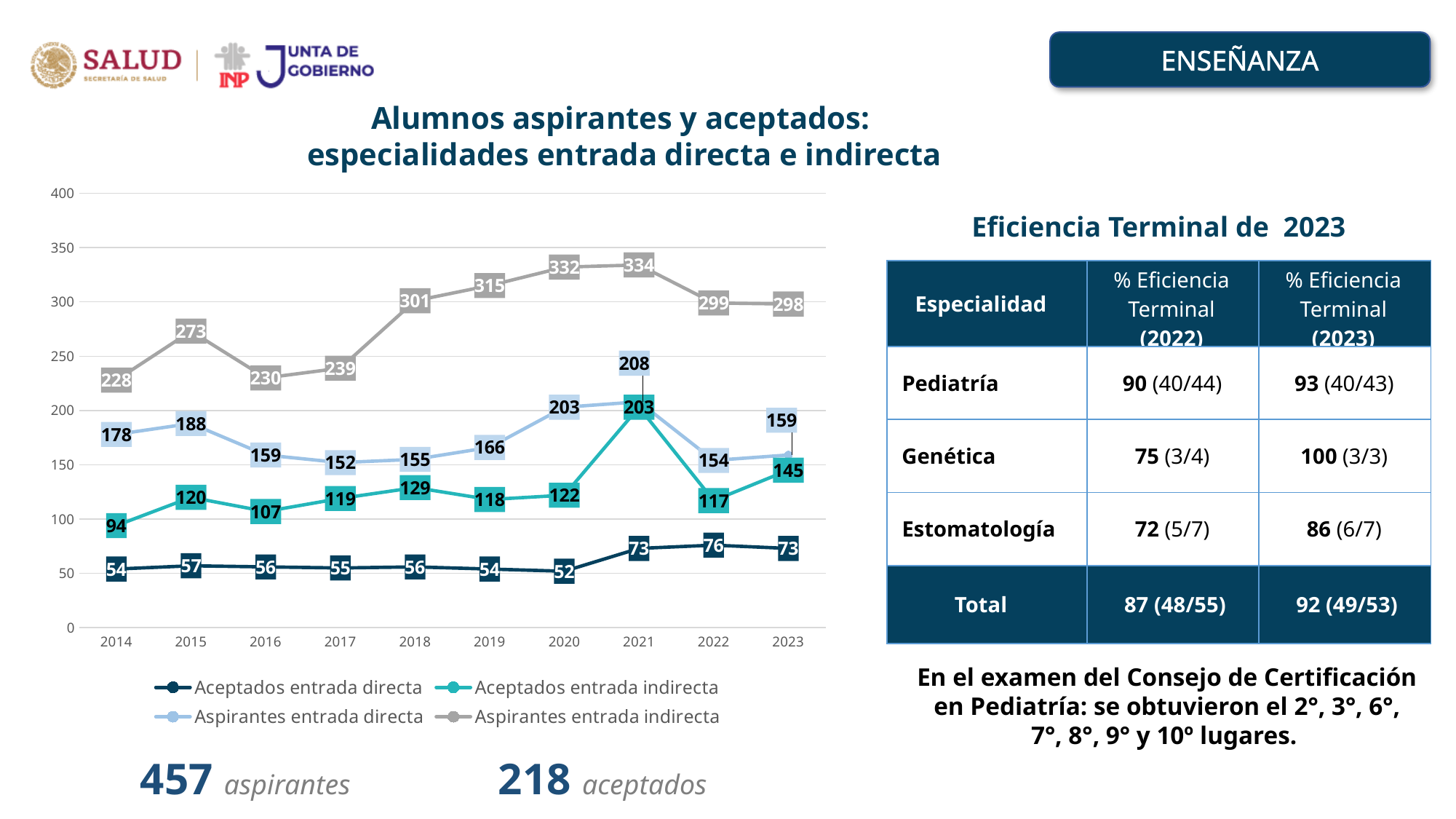
What is the value for Aceptados entrada indirecta in 2023? 145 What is the title of the chart? Alumnos aspirantes y aceptados: especialidades entrada directa e indirecta What is the value for Aceptados entrada directa in 2022? 76 How many series does the chart legend list? 4 What kind of chart is shown on the slide? line chart In which year is Aceptados entrada directa lowest? 2020 Which year has the larger value for Aceptados entrada indirecta, 2021 or 2022? 2021 Does Aspirantes entrada indirecta rise or fall from 2017 to 2021? rise What is the difference between Aspirantes entrada directa in 2015 and in 2014? 10 How many years are plotted along the x axis of the chart? 10 In which year is Aspirantes entrada indirecta highest? 2021 What is the value for Aspirantes entrada indirecta in 2021? 334